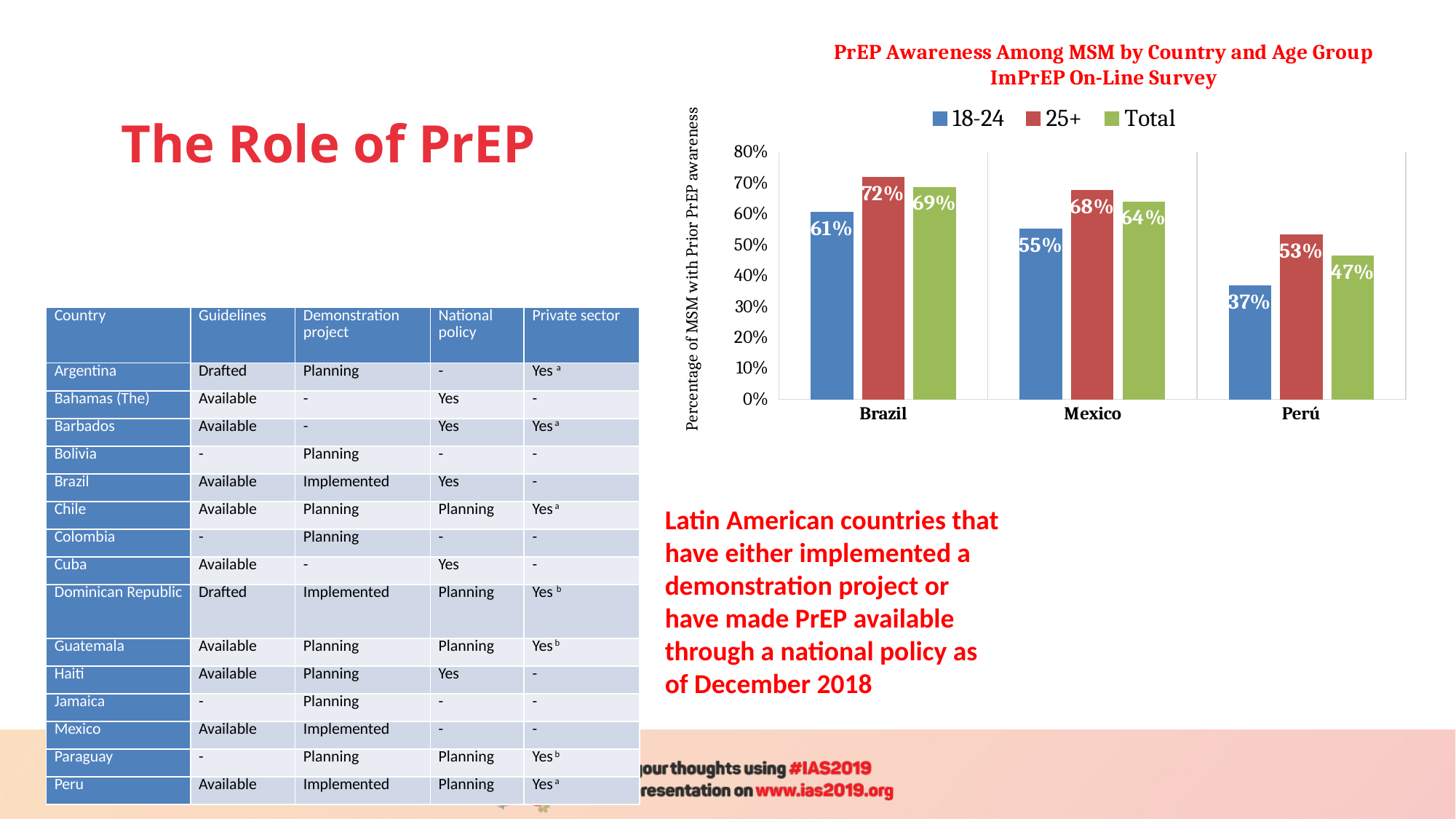
What is the difference between the 25+ and 18-24 PrEP awareness values in Perú? 16% What is the label of the vertical axis of the chart? Percentage of MSM with Prior PrEP awareness Which country has the lowest PrEP awareness among the 18-24 age group? Perú What is the Total PrEP awareness value for Perú? 47% What kind of chart is used to show PrEP awareness among MSM? Bar chart How many countries are shown on the x axis of the chart? 3 Which country has the highest Total PrEP awareness? Brazil How many series does the chart legend list? 3 Is the 25+ PrEP awareness value higher in Brazil or in Mexico? Brazil What is the PrEP awareness value for the 25+ age group in Mexico? 68% What is the PrEP awareness value for the 18-24 age group in Brazil? 61% Is the 18-24 PrEP awareness value for Perú greater or less than 40%? less